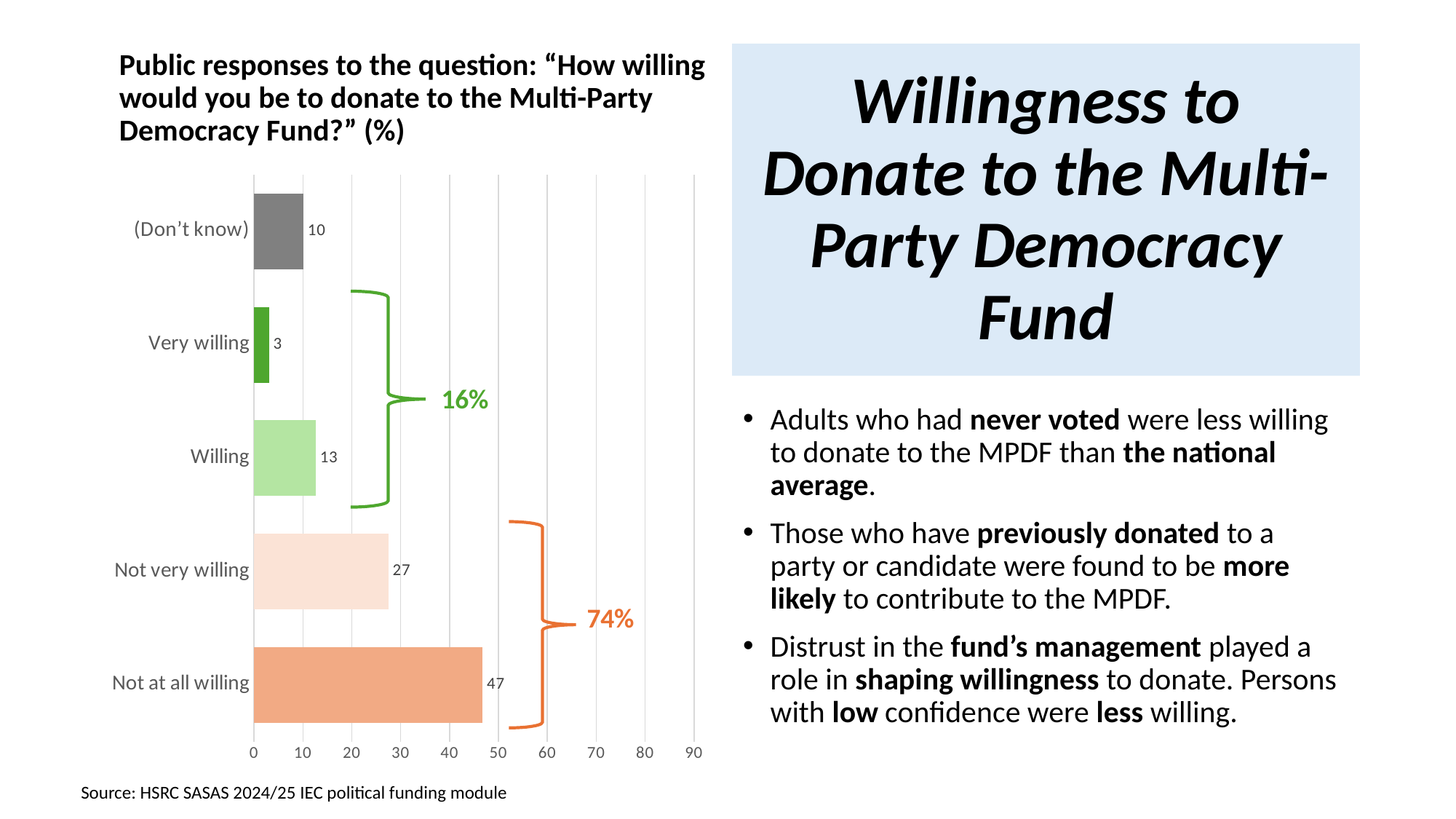
What is the difference between the values for "Not at all willing" and "Not very willing"? 20 Is the value for "Not very willing" greater or less than 20? greater What is the value for "Very willing"? 3 Which category has the highest value? Not at all willing What kind of chart is shown on the slide? Bar chart What is the value for "Not at all willing"? 47 What combined percentage is shown by the orange bracket grouping "Not very willing" and "Not at all willing"? 74% How many categories are shown in the chart? 5 What is the value for "(Don't know)"? 10 What combined percentage is shown by the green bracket grouping "Very willing" and "Willing"? 16% Which is larger, the value for "Willing" or the value for "(Don't know)"? Willing Which category has the lowest value? Very willing